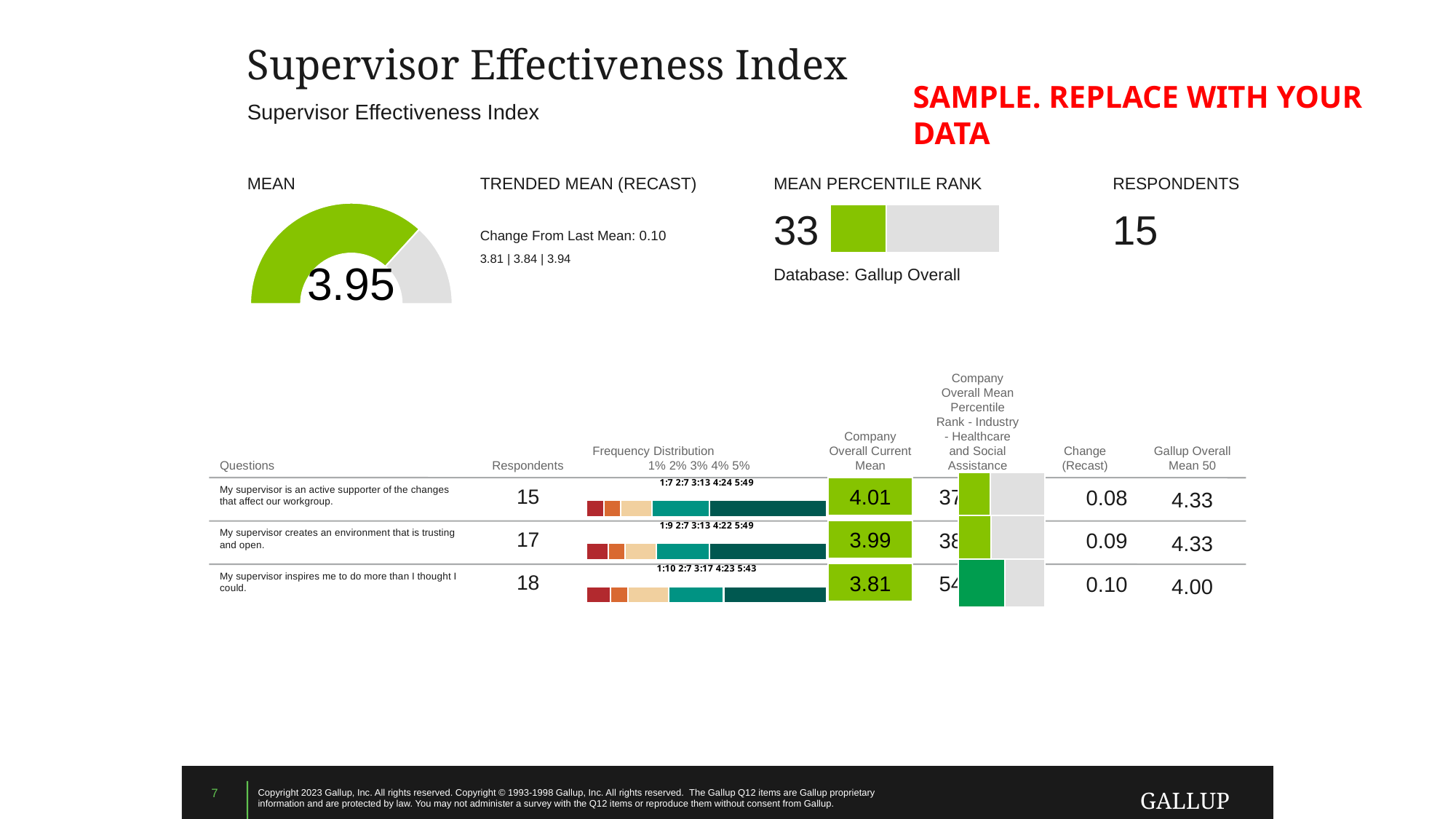
What is the difference between the response-5 values in the Frequency Distribution bars for 'My supervisor is an active supporter of the changes that affect our workgroup.' (49) and 'My supervisor inspires me to do more than I thought I could.' (43)? 6 In the Frequency Distribution bar for 'My supervisor inspires me to do more than I thought I could.', what is the value labelled for response 1? 10 What kind of chart is used to show the MEAN of 3.95? gauge chart Which question has the lowest labelled value for response 5 in its Frequency Distribution bar? My supervisor inspires me to do more than I thought I could. How many Frequency Distribution bars are shown in the table? 3 Is the MEAN PERCENTILE RANK bar filled to greater or less than 50 percent of its length? less How many segments does each Frequency Distribution stacked bar contain? 5 What is the MEAN PERCENTILE RANK shown next to the horizontal bar? 33 What value does the MEAN gauge chart display? 3.95 Which has the larger response-3 value in its Frequency Distribution bar: 'My supervisor is an active supporter of the changes that affect our workgroup.' or 'My supervisor inspires me to do more than I thought I could.'? My supervisor inspires me to do more than I thought I could. In the Frequency Distribution bar for 'My supervisor is an active supporter of the changes that affect our workgroup.', what is the value labelled for response 5? 49 Do the TRENDED MEAN (RECAST) values 3.81 | 3.84 | 3.94 rise or fall over time? rise